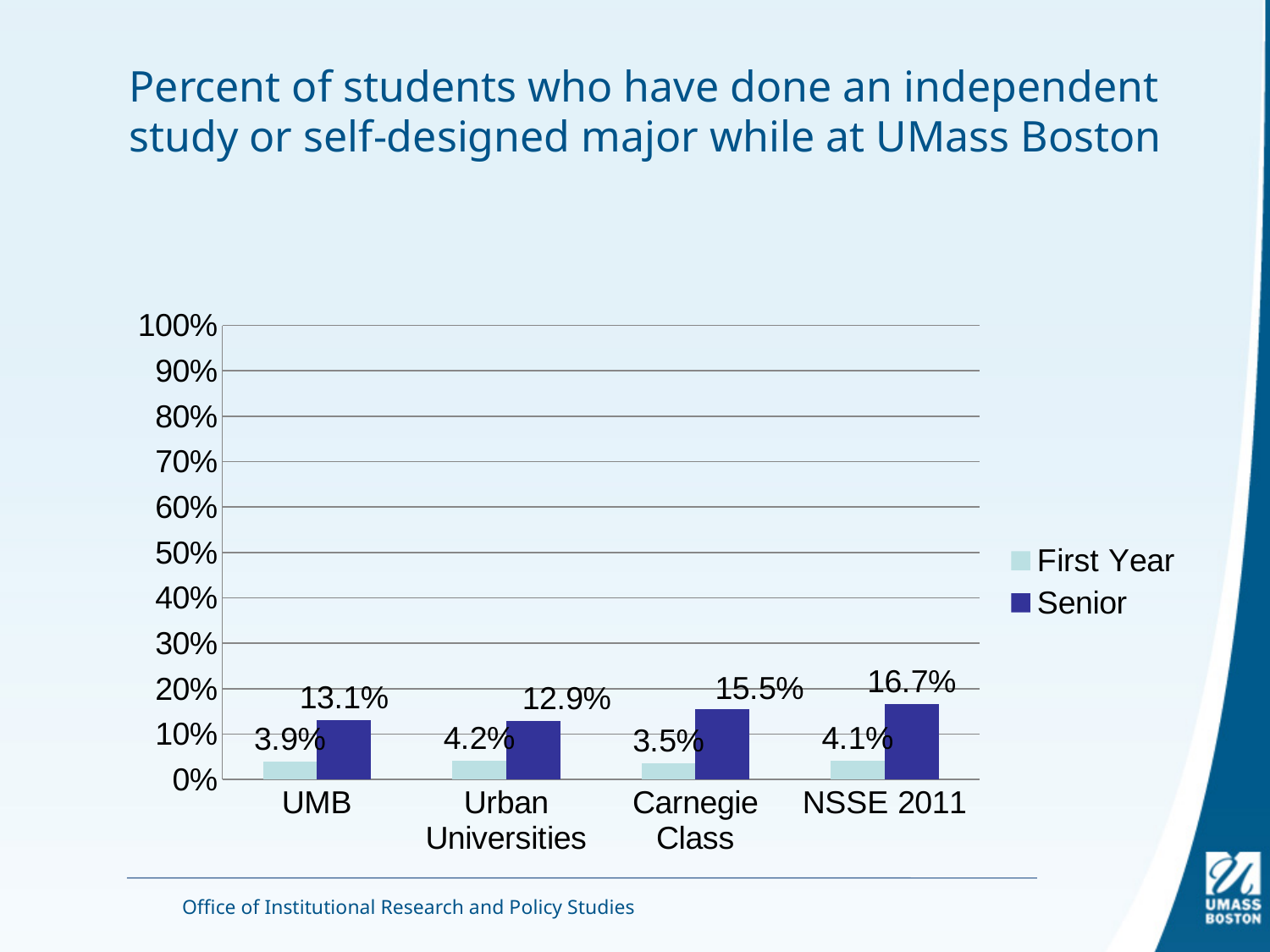
Is the Senior value for NSSE 2011 greater or less than 20%? less How many series does the legend list? 2 What are the two series named in the legend? First Year and Senior What kind of chart is shown on the slide? bar chart How many categories are shown on the x axis? 4 What is the First Year value for Carnegie Class? 3.5% What is the Senior value for UMB? 13.1% Which category has the highest Senior value? NSSE 2011 Which category has the lowest First Year value? Carnegie Class What is the difference between the Senior and First Year values for Urban Universities? 8.7% Which is larger, the Senior value for Carnegie Class or the Senior value for UMB? Carnegie Class What is the Senior value for NSSE 2011? 16.7%